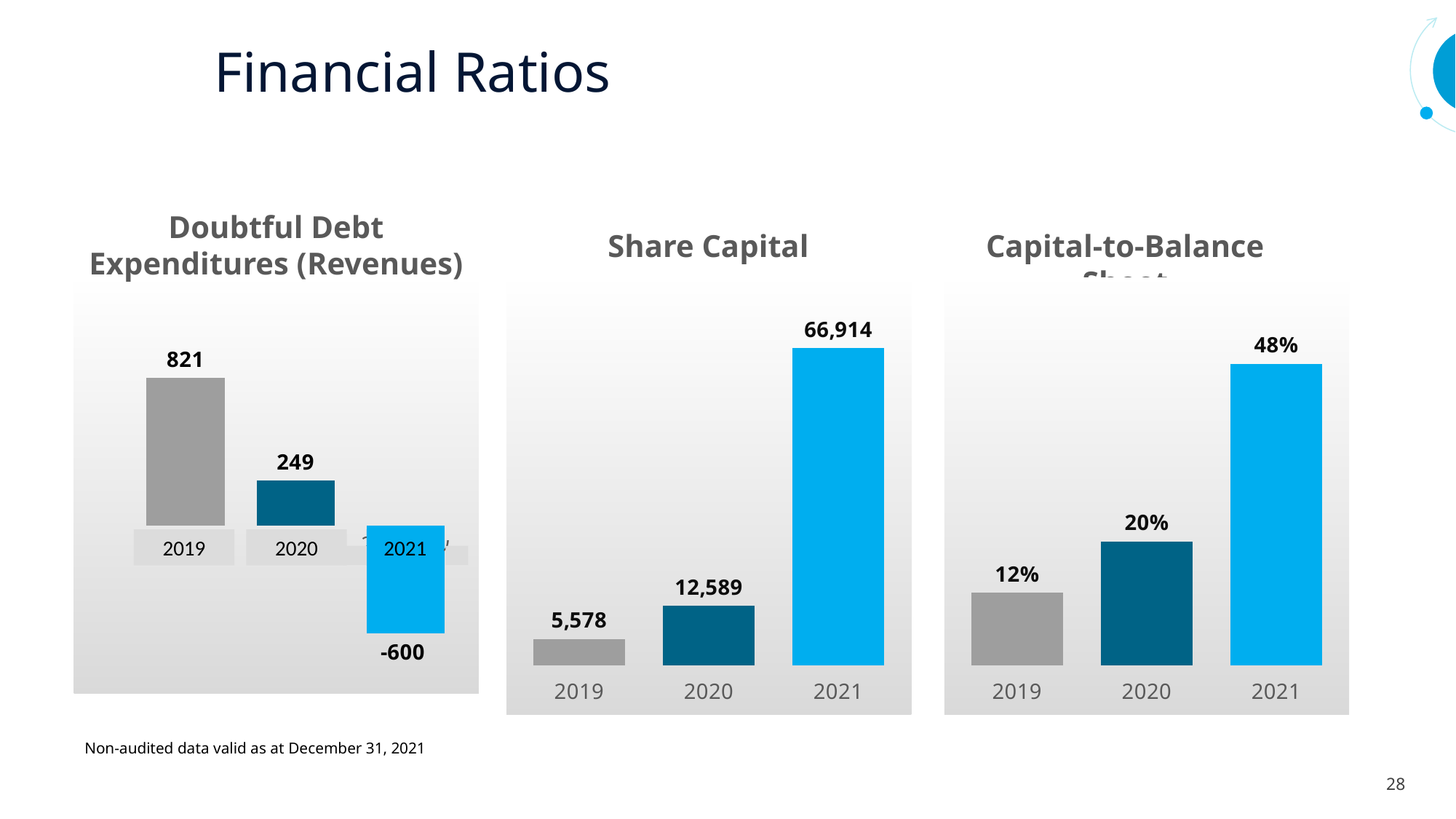
In the Doubtful Debt Expenditures (Revenues) chart, what is the value for 2019? 821 In the Doubtful Debt Expenditures (Revenues) chart, what is the value for 2021? -600 What type of chart is the Share Capital chart? bar chart In the Share Capital chart, do the values rise or fall from 2019 to 2021? rise In the Share Capital chart, what is the value for 2020? 12,589 In the Share Capital chart, which year has the lowest value? 2019 In the rightmost chart (Capital-to-Balance), how many years are shown? 3 In the Doubtful Debt Expenditures (Revenues) chart, which year has the highest value? 2019 In the rightmost chart (Capital-to-Balance), which year has the highest value? 2021 In the rightmost chart (Capital-to-Balance), what is the value for 2020? 20% In the Doubtful Debt Expenditures (Revenues) chart, what is the difference between the 2019 and 2020 values? 572 In the Share Capital chart, what is the difference between the 2021 and 2020 values? 54,325